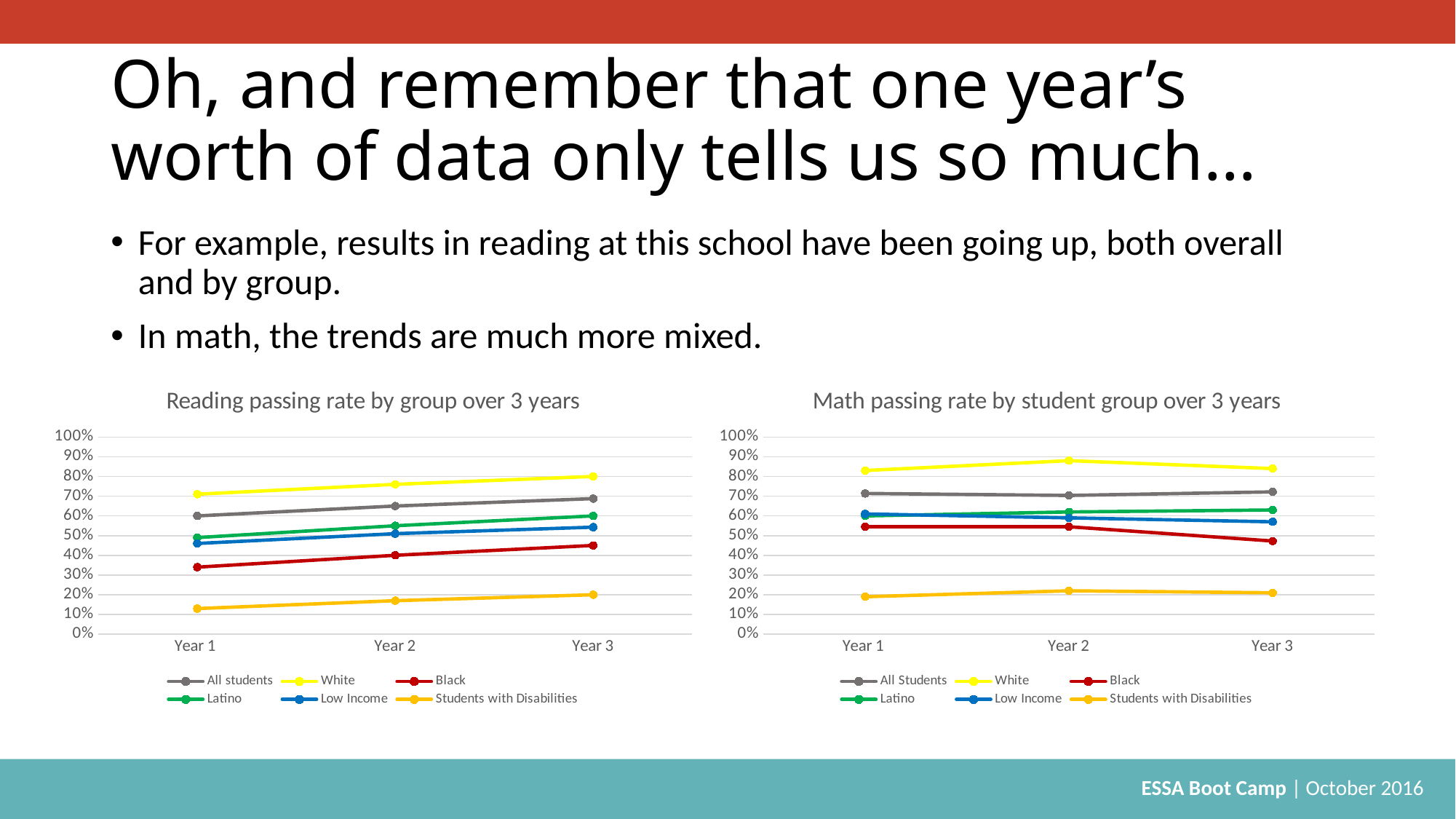
In the 'Math passing rate by student group over 3 years' chart, does the Black series rise or fall from Year 2 to Year 3? fall In the 'Reading passing rate by group over 3 years' chart, what is the passing rate for White in Year 3? 80% In the 'Reading passing rate by group over 3 years' chart, is the value for Students with Disabilities in Year 1 greater or less than 20%? less In the 'Reading passing rate by group over 3 years' chart, which group has the highest passing rate in Year 3? White How many series does the legend of the 'Reading passing rate by group over 3 years' chart list? 6 In the 'Math passing rate by student group over 3 years' chart, is the value for White in Year 2 greater or less than 80%? greater In the 'Math passing rate by student group over 3 years' chart, which is larger in Year 3: All Students or Black? All Students How many years are plotted on the x axis of the 'Math passing rate by student group over 3 years' chart? 3 What is the title of the chart on the right side of the slide? Math passing rate by student group over 3 years What kind of chart is the 'Reading passing rate by group over 3 years' chart? line chart In the 'Math passing rate by student group over 3 years' chart, which group has the lowest passing rate in Year 2? Students with Disabilities In the 'Reading passing rate by group over 3 years' chart, does the Black series rise or fall from Year 1 to Year 3? rise